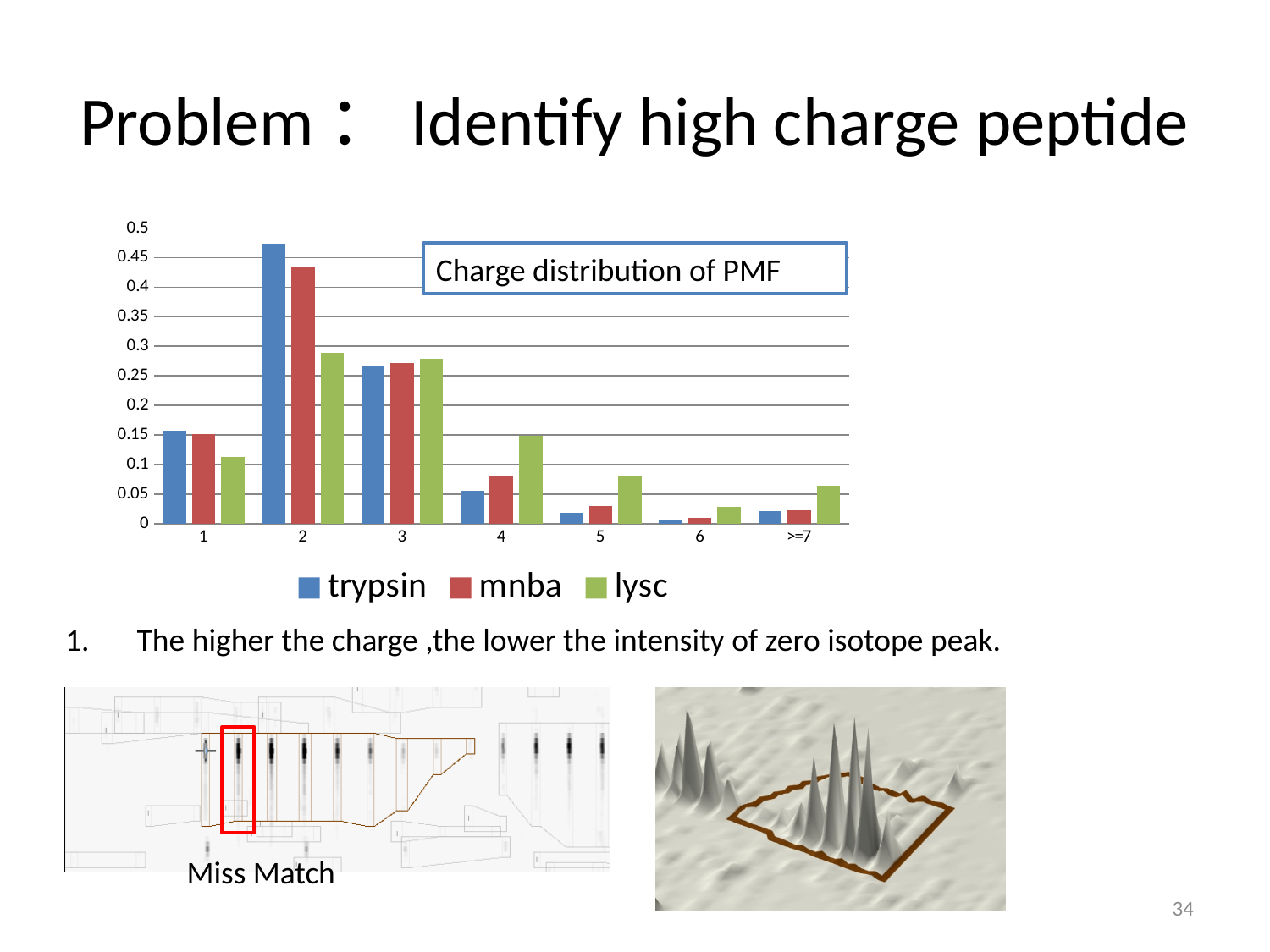
Is the value for lysc at charge 4 greater or less than 0.1? greater Is the value for lysc at charge 2 greater or less than 0.35? less Which charge category has the highest value for mnba? 2 What is the title shown in the box on the chart? Charge distribution of PMF At charge 2, which series has the larger value, trypsin or lysc? trypsin At charge 5, which series has the larger value, trypsin or lysc? lysc What kind of chart is shown on the slide? bar chart How many series does the legend list? 3 Which charge category has the highest value for trypsin? 2 How many charge categories are shown on the x axis? 7 Is the value for trypsin at charge 4 greater or less than 0.1? less